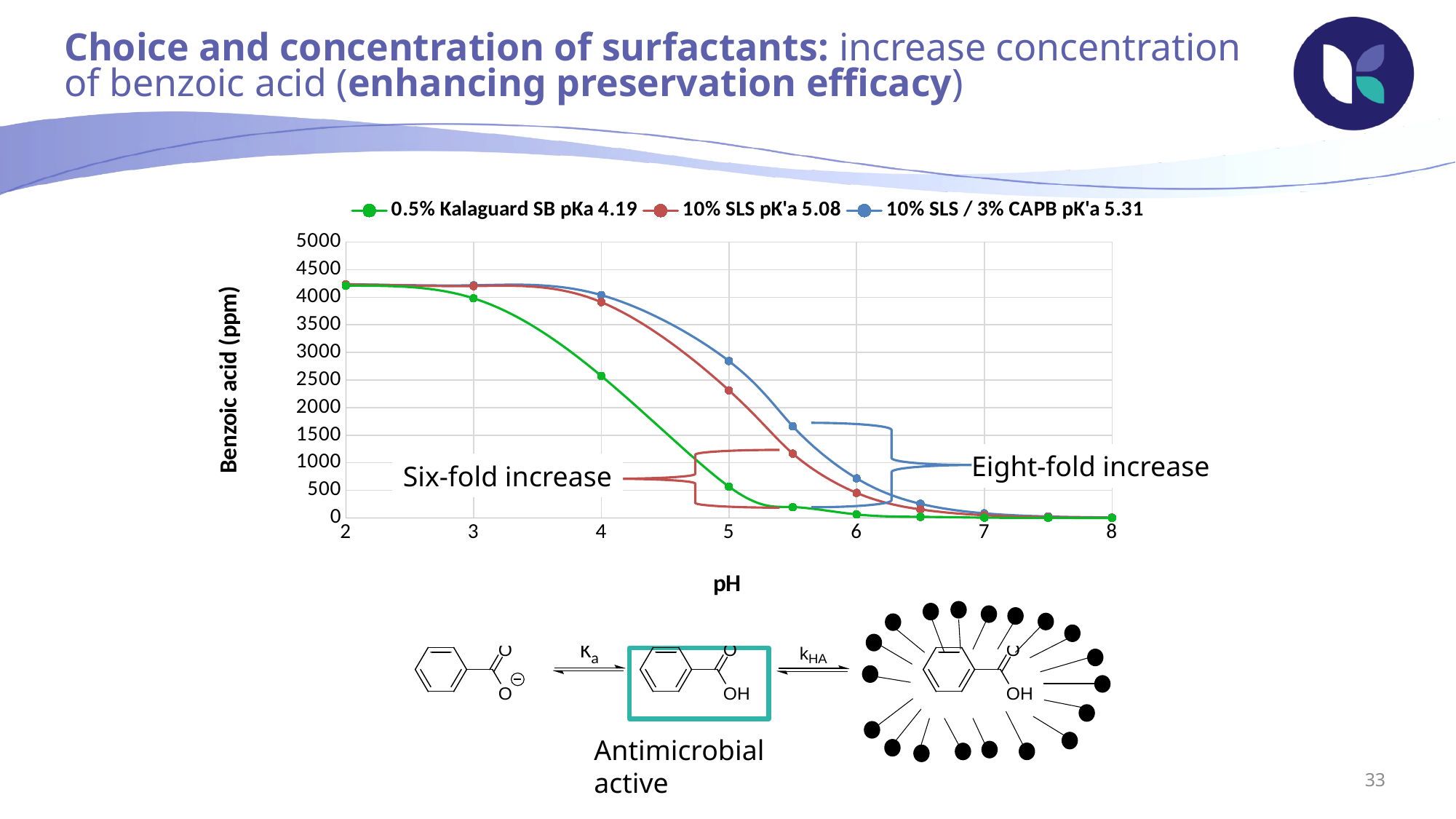
What kind of chart is shown on the slide? Line chart Is the value for 10% SLS at pH 5 greater or less than 2500? less Is the value for 0.5% Kalaguard SB at pH 4 greater or less than 2000? greater Do the benzoic acid values rise or fall as pH increases along the x axis? Fall Is the value for 10% SLS / 3% CAPB at pH 5.5 greater or less than 1500? greater How many series does the chart legend list? 3 Which series in the legend has pK'a 5.31? 10% SLS / 3% CAPB pK'a 5.31 At pH 5, which series has the higher benzoic acid value: 10% SLS / 3% CAPB or 0.5% Kalaguard SB? 10% SLS / 3% CAPB At pH 4, which series has the higher benzoic acid value: 10% SLS or 0.5% Kalaguard SB? 10% SLS What is the title of the vertical axis of the chart? Benzoic acid (ppm)